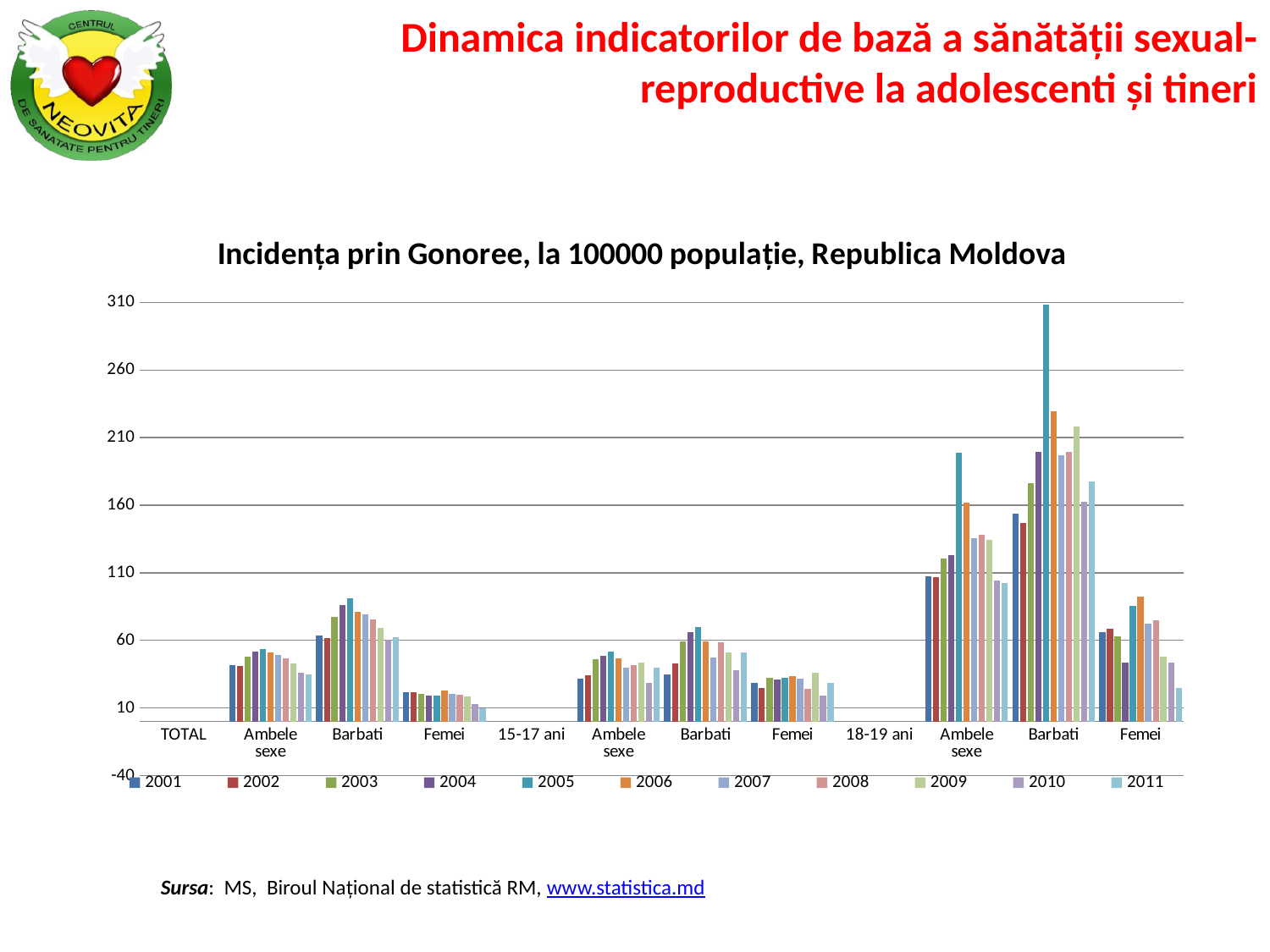
For 2005, which is larger: Barbati or Femei in the 18-19 ani group? Barbati Is the 2011 value for Femei in the first (TOTAL) group greater or less than 60? less Which year has the highest value for Barbati in the 18-19 ani group? 2005 Which years are the first and last entries in the legend? 2001 and 2011 Which category group contains the tallest bar in the chart? Barbati (18-19 ani) How many series does the chart legend list? 11 For 2005, which is larger: Ambele sexe or Femei in the first (TOTAL) group? Ambele sexe Is the 2005 value for Ambele sexe in the 18-19 ani group greater or less than 160? greater Is the 2005 value for Barbati in the 18-19 ani group greater or less than 260? greater What kind of chart is shown on the slide? bar chart What is the title of the chart? Incidența prin Gonoree, la 100000 populație, Republica Moldova How many category labels are shown along the x axis? 12